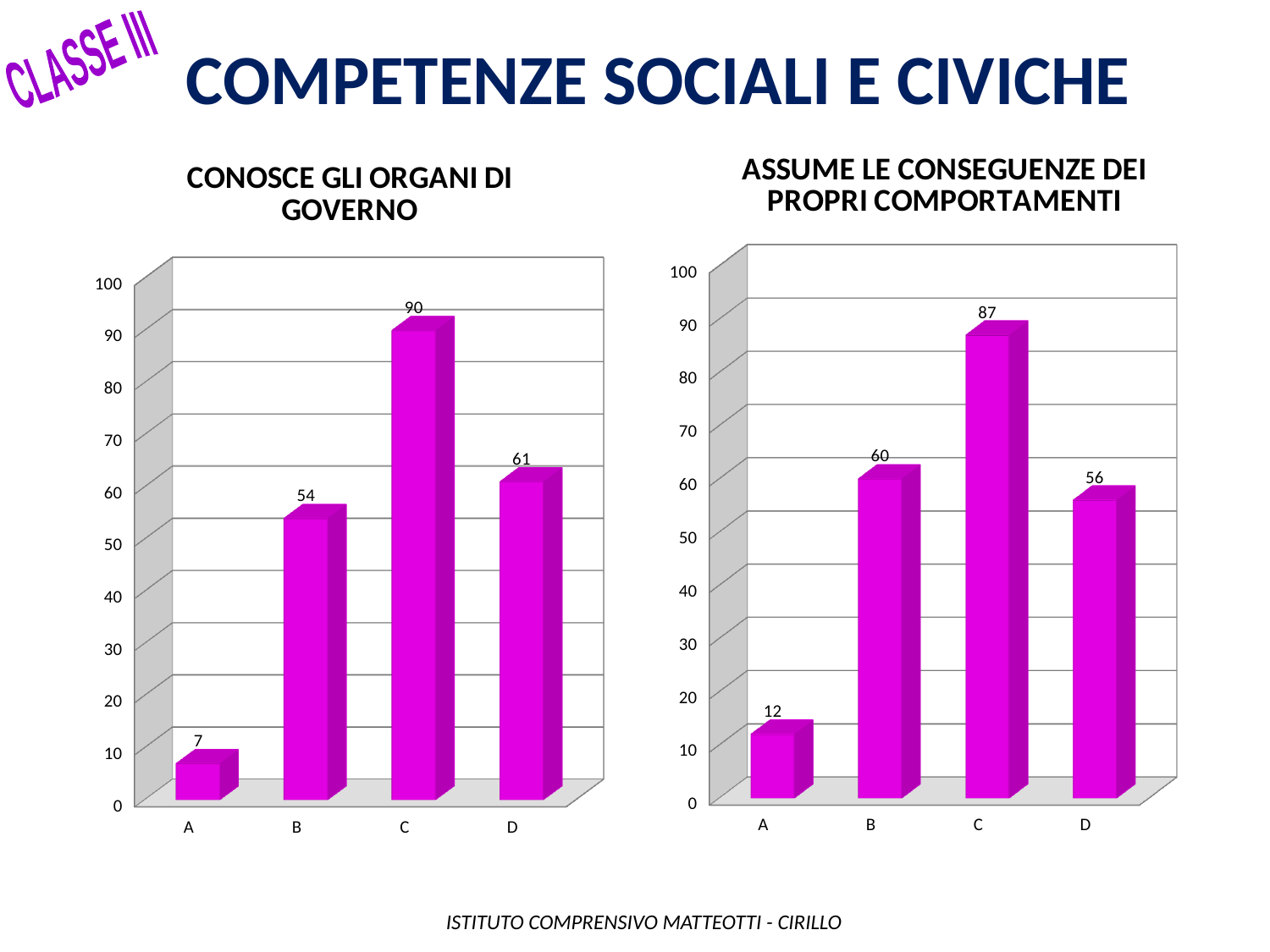
In the 'ASSUME LE CONSEGUENZE DEI PROPRI COMPORTAMENTI' chart, what is the value for category B? 60 In the 'ASSUME LE CONSEGUENZE DEI PROPRI COMPORTAMENTI' chart, is the value for C greater or less than 80? greater In the 'CONOSCE GLI ORGANI DI GOVERNO' chart, which is larger, the value for B or the value for D? D In the 'ASSUME LE CONSEGUENZE DEI PROPRI COMPORTAMENTI' chart, which category has the lowest value? A In the 'ASSUME LE CONSEGUENZE DEI PROPRI COMPORTAMENTI' chart, what is the value for category D? 56 In the 'CONOSCE GLI ORGANI DI GOVERNO' chart, what is the value for category A? 7 What kind of chart is the 'ASSUME LE CONSEGUENZE DEI PROPRI COMPORTAMENTI' chart? Bar chart In the 'ASSUME LE CONSEGUENZE DEI PROPRI COMPORTAMENTI' chart, what is the difference between the values for C and A? 75 How many categories are shown in the 'CONOSCE GLI ORGANI DI GOVERNO' chart? 4 In the 'CONOSCE GLI ORGANI DI GOVERNO' chart, what is the difference between the values for C and D? 29 In the 'CONOSCE GLI ORGANI DI GOVERNO' chart, what is the value for category C? 90 In the 'CONOSCE GLI ORGANI DI GOVERNO' chart, which category has the highest value? C